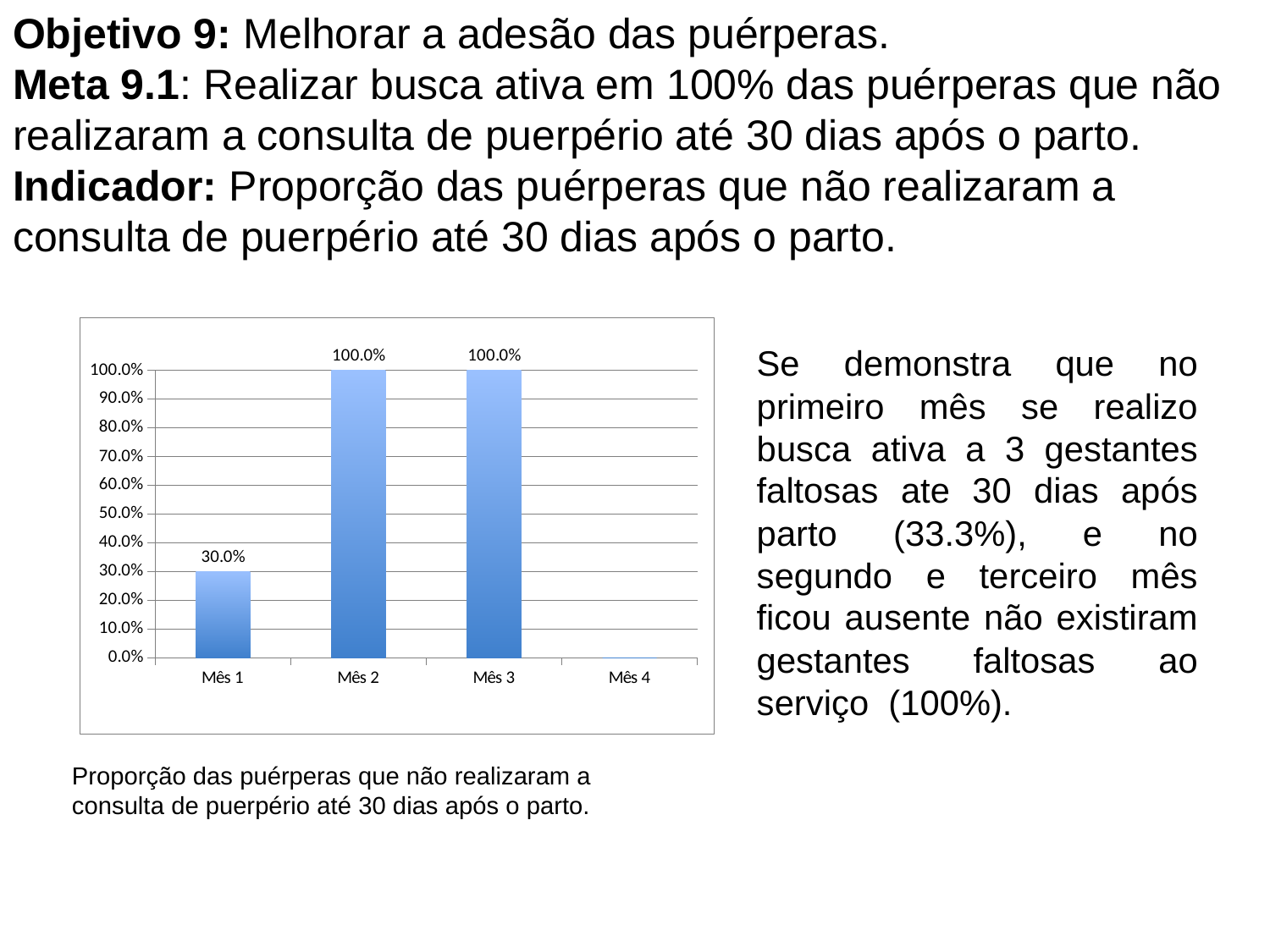
Which month category has no bar plotted? Mês 4 How many month categories are shown on the x axis? 4 What is the difference between the values for Mês 2 and Mês 1? 70.0% Which is larger, the value for Mês 1 or the value for Mês 3? Mês 3 What is the highest value shown on the y axis? 100.0% What kind of chart is shown on the slide? bar chart What is the value for Mês 2? 100.0% Which month has the lowest value among the months with a plotted bar? Mês 1 Does the value rise or fall from Mês 1 to Mês 2? rise What is the value for Mês 1? 30.0% Is the value for Mês 1 greater or less than 50.0%? less What is the value for Mês 3? 100.0%